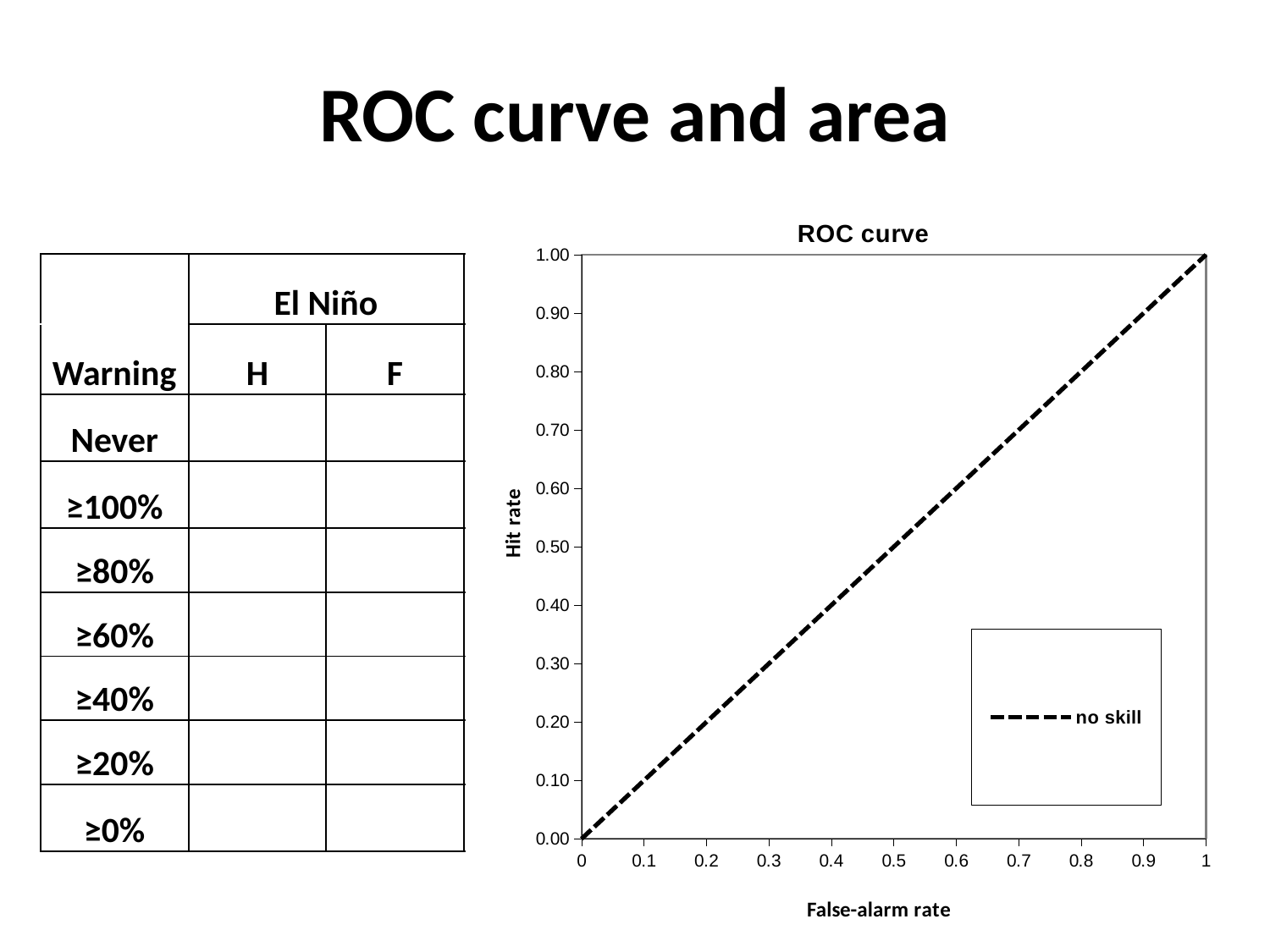
Which false-alarm rate gives the highest hit rate on the no skill line, 0 or 1? 1 Is the hit rate of the no skill line at a false-alarm rate of 0.3 greater or less than 0.40? less Is the hit rate of the no skill line at a false-alarm rate of 0.8 greater or less than 0.70? greater What is the name of the series shown in the legend of the ROC curve chart? no skill What is the hit rate of the no skill line at a false-alarm rate of 0? 0.00 What kind of chart is shown on the slide? line chart What is the hit rate of the no skill line at a false-alarm rate of 1? 1.00 Does the no skill line rise or fall as the false-alarm rate increases? rises What is the title of the chart on the slide? ROC curve How many series does the legend of the ROC curve chart list? 1 At which false-alarm rate does the no skill line reach its highest hit rate? 1 At which false-alarm rate does the no skill line reach its lowest hit rate? 0